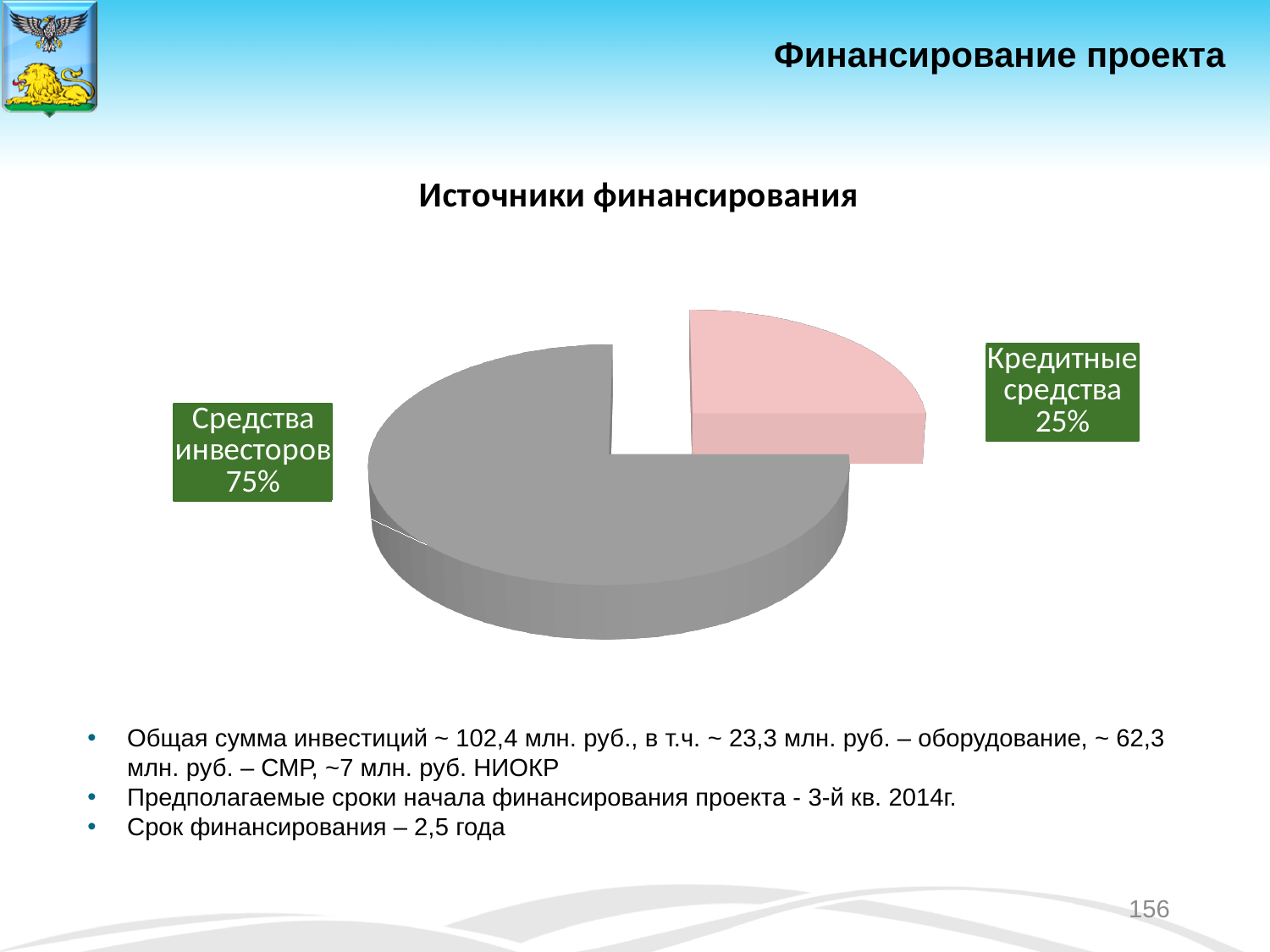
What is the title of the chart? Источники финансирования Which is larger: "Средства инвесторов" or "Кредитные средства"? Средства инвесторов Which slice of the pie is the largest? Средства инвесторов What share of the pie does "Кредитные средства" represent? 25% What is the difference in percentage points between "Средства инвесторов" and "Кредитные средства"? 50 What colour is the "Кредитные средства" slice? Pink How many slices does the pie chart have? 2 What share of the pie does "Средства инвесторов" represent? 75% What kind of chart is shown on the slide? Pie chart Which slice of the pie is the smallest? Кредитные средства